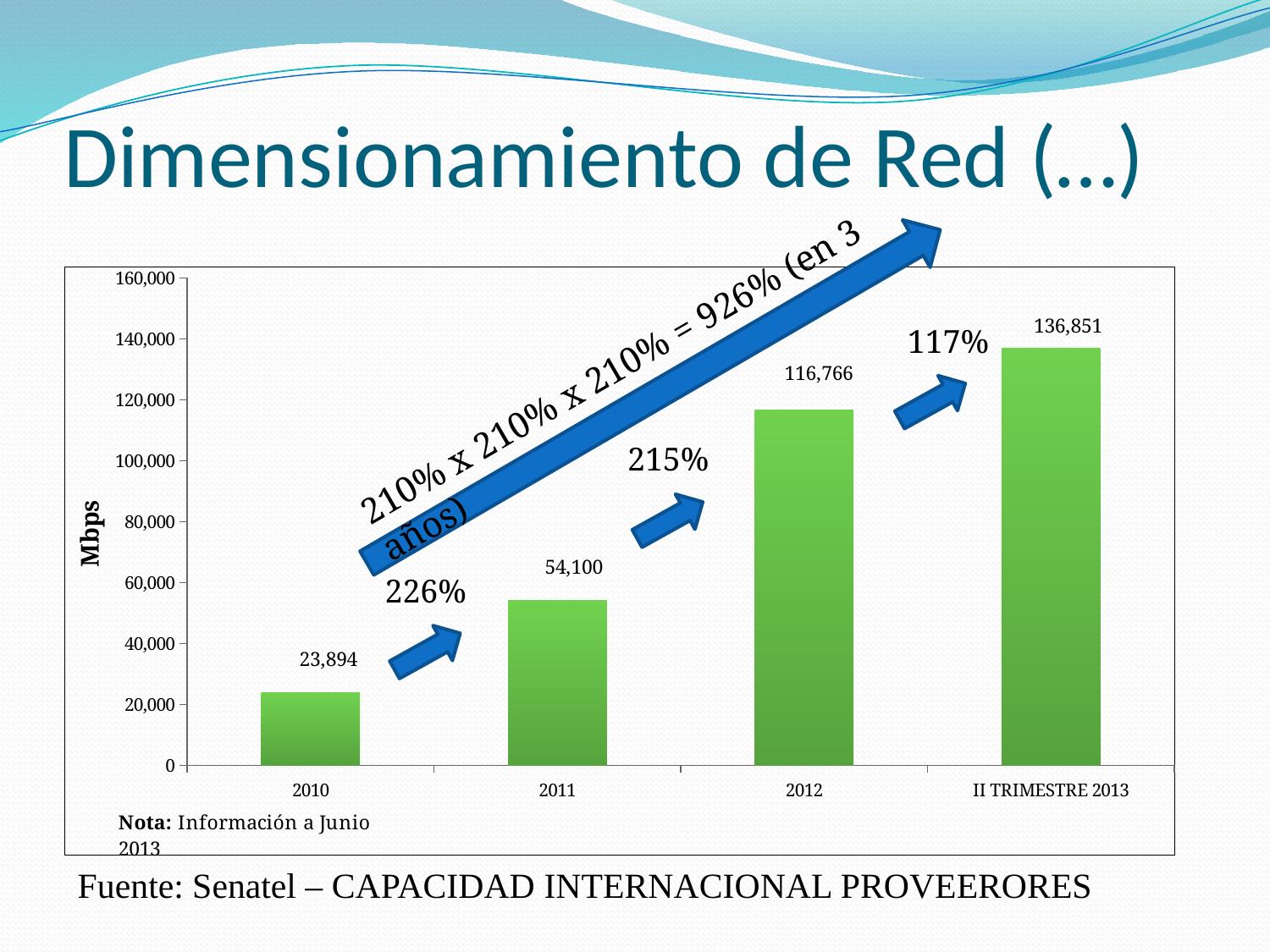
What is the value for II TRIMESTRE 2013? 136,851 What is the value for 2012? 116,766 Which category has the lowest value? 2010 How many bars are shown in the chart? 4 Do the values rise or fall from 2010 to II TRIMESTRE 2013? rise What kind of chart is shown on the slide? bar chart What is the value for 2011? 54,100 What is the difference between the values for 2012 and 2011? 62,666 What is the value for 2010? 23,894 Which category has the highest value? II TRIMESTRE 2013 Which is larger, the value for 2011 or the value for 2012? 2012 What is the label on the vertical axis of the chart? Mbps